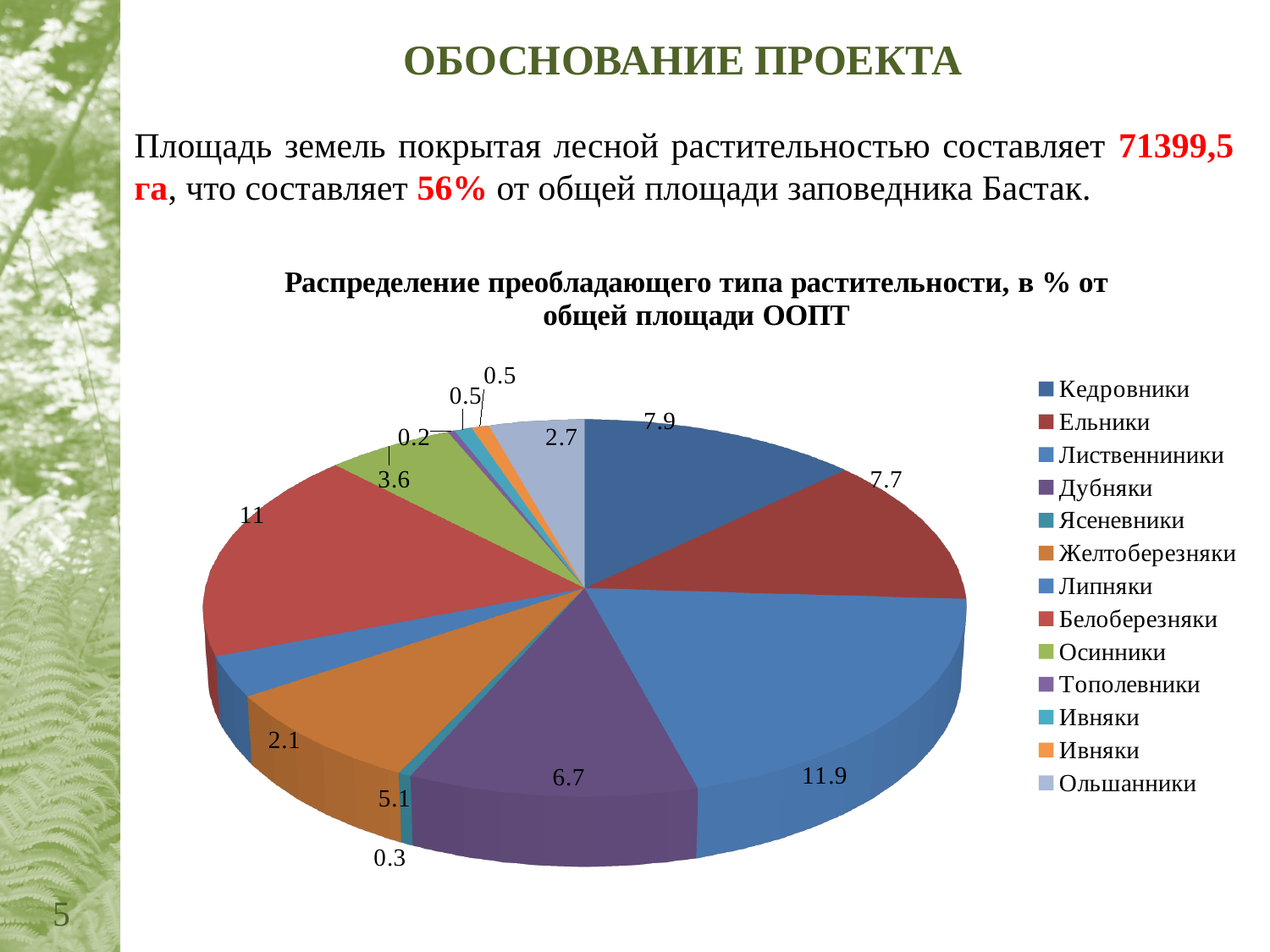
Which category has the largest slice in the pie chart? Лиственниники What is the title of the pie chart? Распределение преобладающего типа растительности, в % от общей площади ООПТ What is the value for Кедровники in the pie chart? 7.9 What is the value for Ольшанники in the pie chart? 2.7 What is the value for Белоберезняки in the pie chart? 11 What is the value for Желтоберезняки in the pie chart? 5.1 Which is larger, the value for Ельники or the value for Осинники? Ельники What is the difference between the values for Лиственниники and Дубняки? 5.2 How many entries does the legend of the pie chart list? 13 What is the value for Лиственниники in the pie chart? 11.9 Which category has the smallest slice in the pie chart? Тополевники What kind of chart is shown on the slide? pie chart